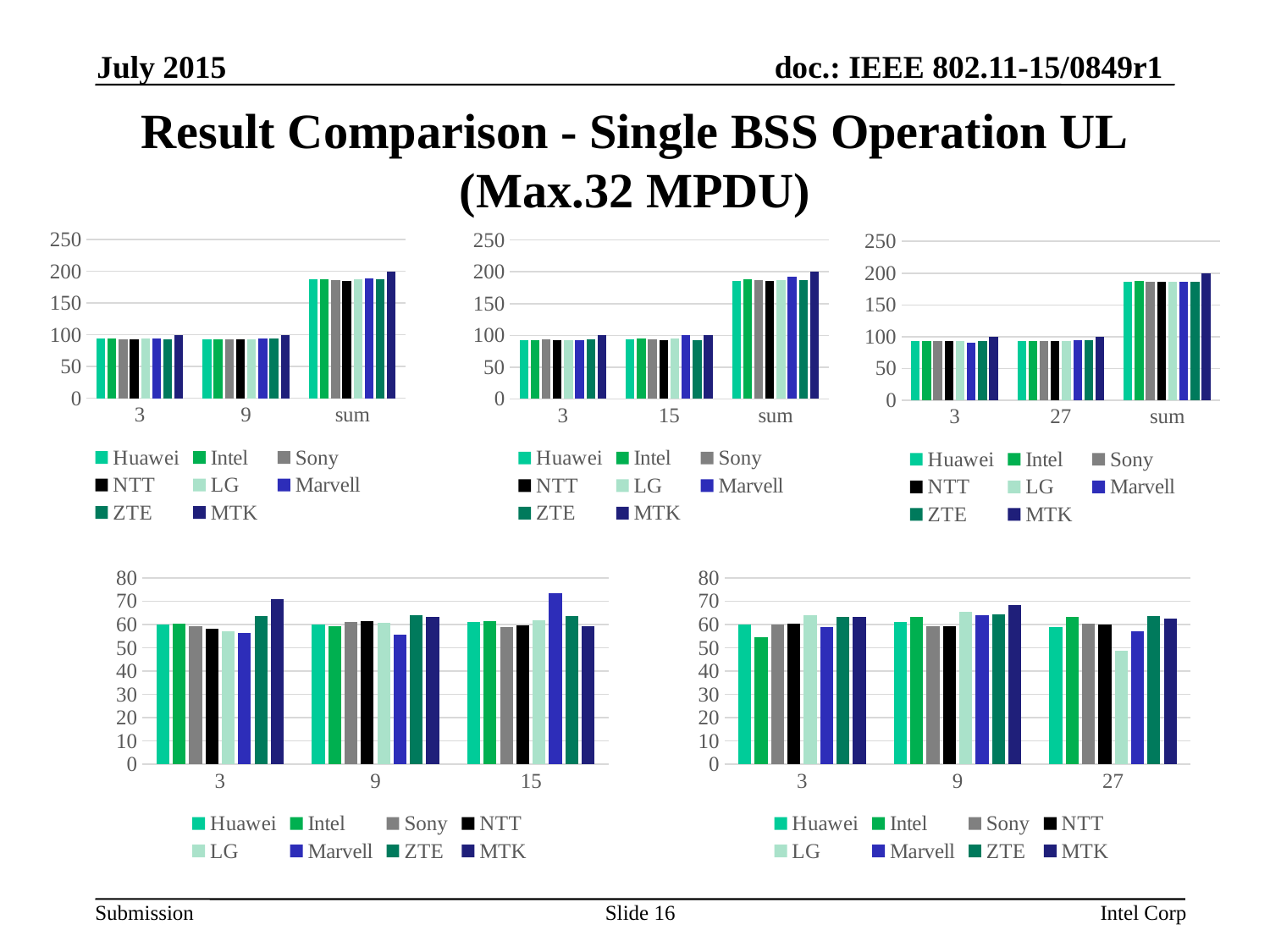
How many categories are shown on the x axis of the bottom-left chart? 3 In the bottom-right chart, which is larger in category '3': the value for Intel or the value for LG? LG How many series does the legend of the top-left chart list? 8 In the top-left chart, is the value for MTK in the 'sum' category greater or less than 150? greater In the bottom-left chart, which series has the highest bar in category '15'? Marvell What kind of chart is the top-left chart? bar chart In the top-right chart, which series has the highest bar in the 'sum' category? MTK In the bottom-right chart, which series has the lowest bar in category '27'? LG In the top-middle chart, is the value for Huawei in category '3' greater or less than 150? less What are the category labels on the x axis of the top-right chart? 3, 27, sum In the bottom-left chart, which series has the lowest bar in category '9'? Marvell